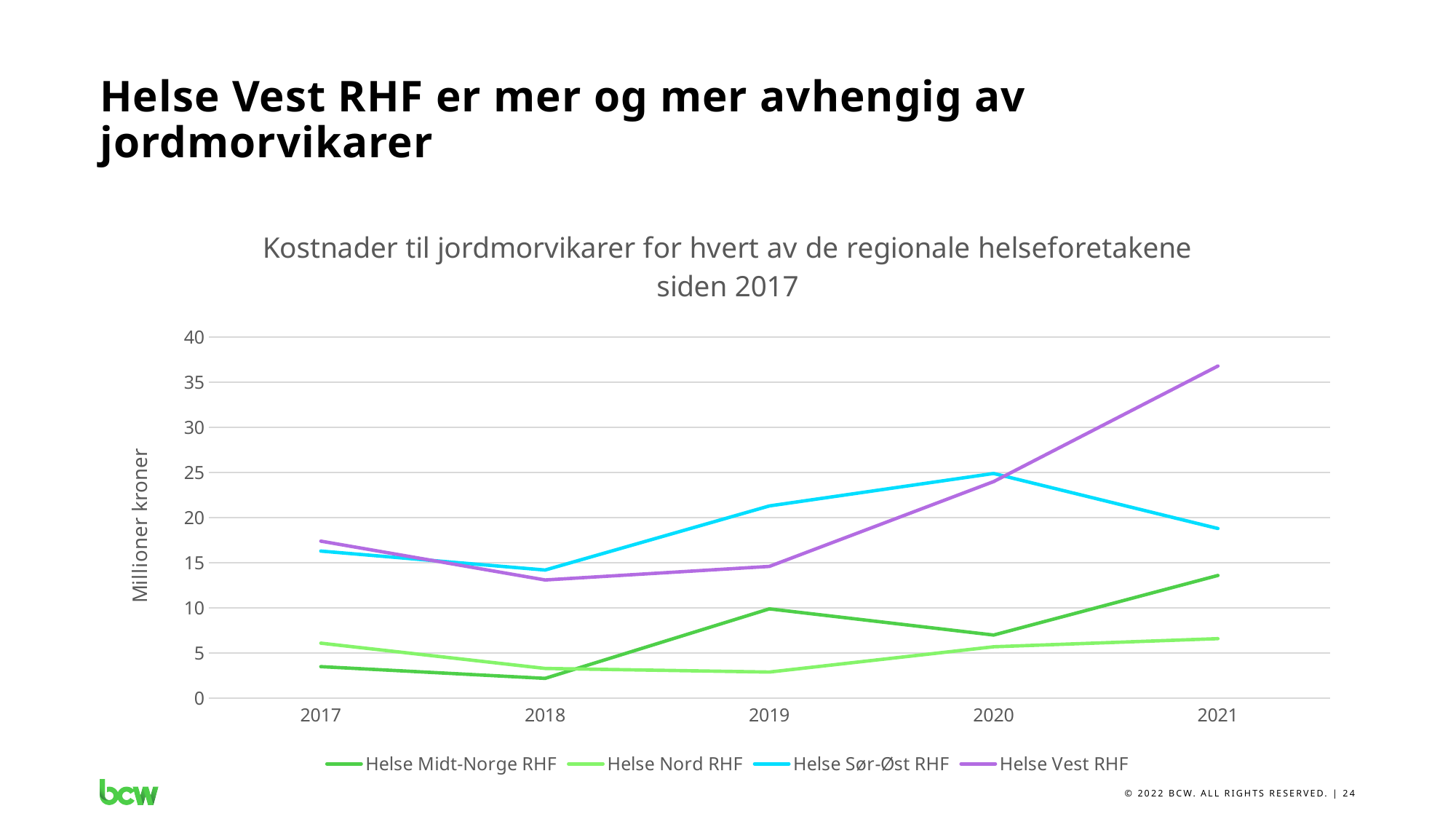
In 2019, which is larger: the value for Helse Sør-Øst RHF or the value for Helse Vest RHF? Helse Sør-Øst RHF How many years are plotted along the x axis? 5 Which series has the highest value in 2019? Helse Sør-Øst RHF What is the label on the y axis? Millioner kroner Which series has the lowest value in 2019? Helse Nord RHF What kind of chart is shown on the slide? line chart How many series does the legend list? 4 Is the value for Helse Vest RHF in 2021 greater or less than 35? greater Is the value for Helse Nord RHF in 2021 greater or less than 10? less Is the value for Helse Sør-Øst RHF in 2020 greater or less than 20? greater Which series has the highest value in 2021? Helse Vest RHF Does the value for Helse Vest RHF rise or fall from 2018 to 2021? rise